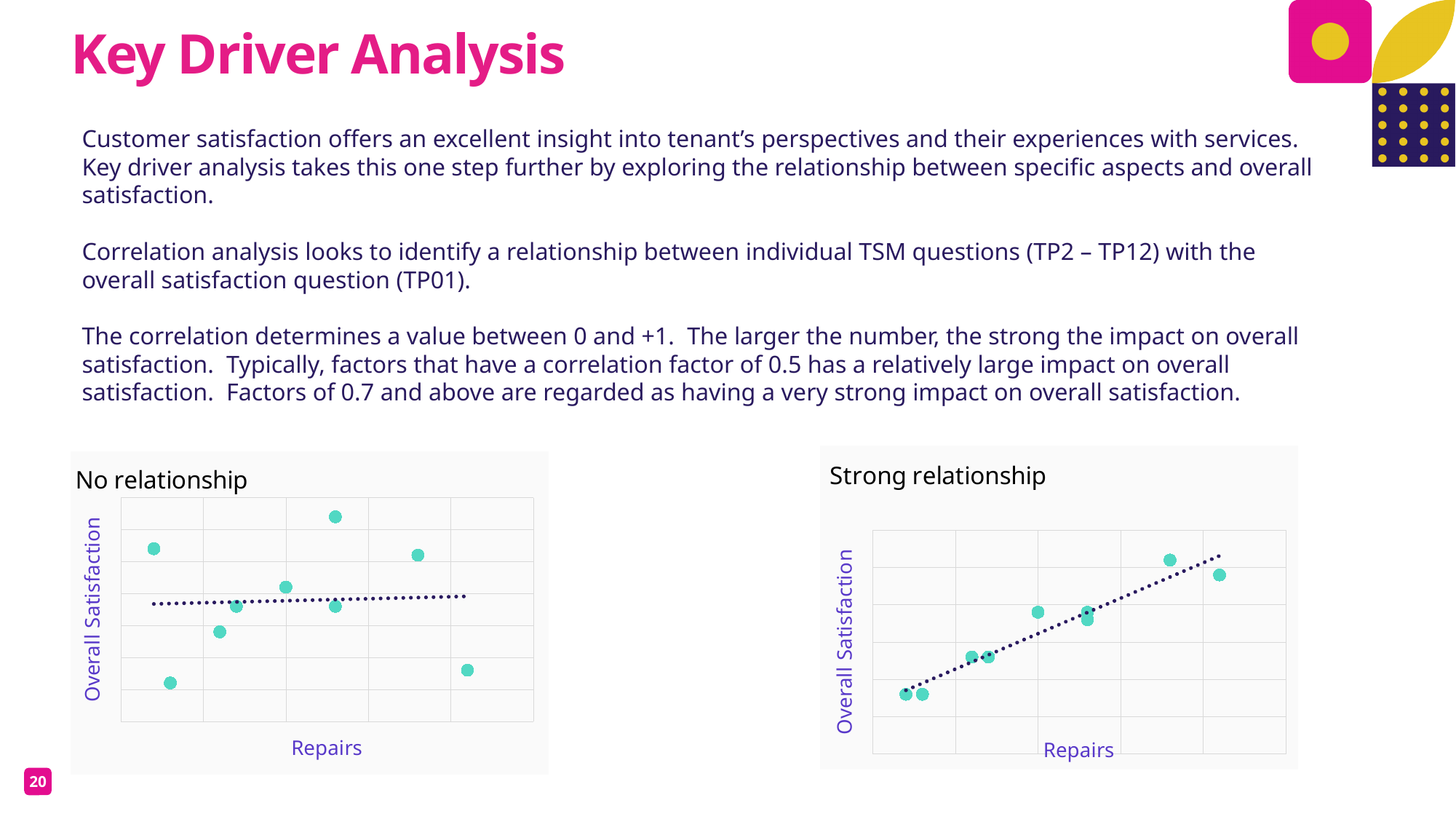
In the 'No relationship' chart, does the dotted trend line rise, fall, or stay roughly flat along the x axis? roughly flat What kind of chart is the 'No relationship' chart? scatter chart What is the x-axis label of the 'Strong relationship' chart? Repairs How many charts are shown on the slide? 2 What kind of chart is the 'Strong relationship' chart? scatter chart What is the y-axis label of the 'No relationship' chart? Overall Satisfaction In the 'Strong relationship' chart, do the points rise or fall as Repairs increases along the x axis? rise How many data points are plotted in the 'No relationship' chart? 9